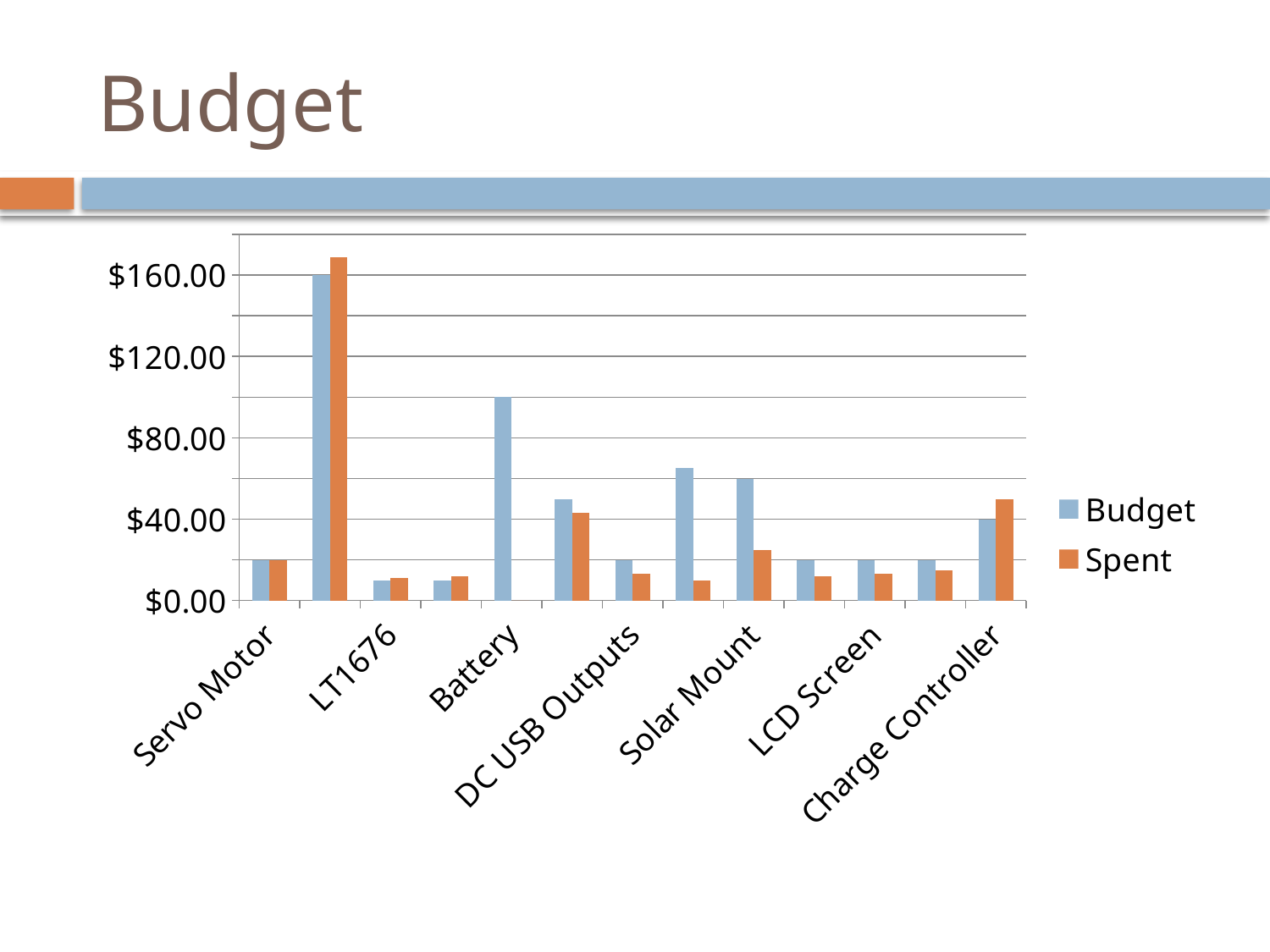
For Solar Mount, which is larger: Budget or Spent? Budget How many series does the legend list? 2 Which colour represents the Spent series? orange Is the Spent value for LT1676 greater or less than $40.00? less What kind of chart is shown on the slide? bar chart Is the Budget value for Solar Mount greater or less than $40.00? greater Is the Budget value for Battery greater or less than $80.00? greater Which is larger: the Budget value for Battery or the Budget value for Solar Mount? Battery For Charge Controller, which is larger: Budget or Spent? Spent What are the two series named in the legend? Budget and Spent